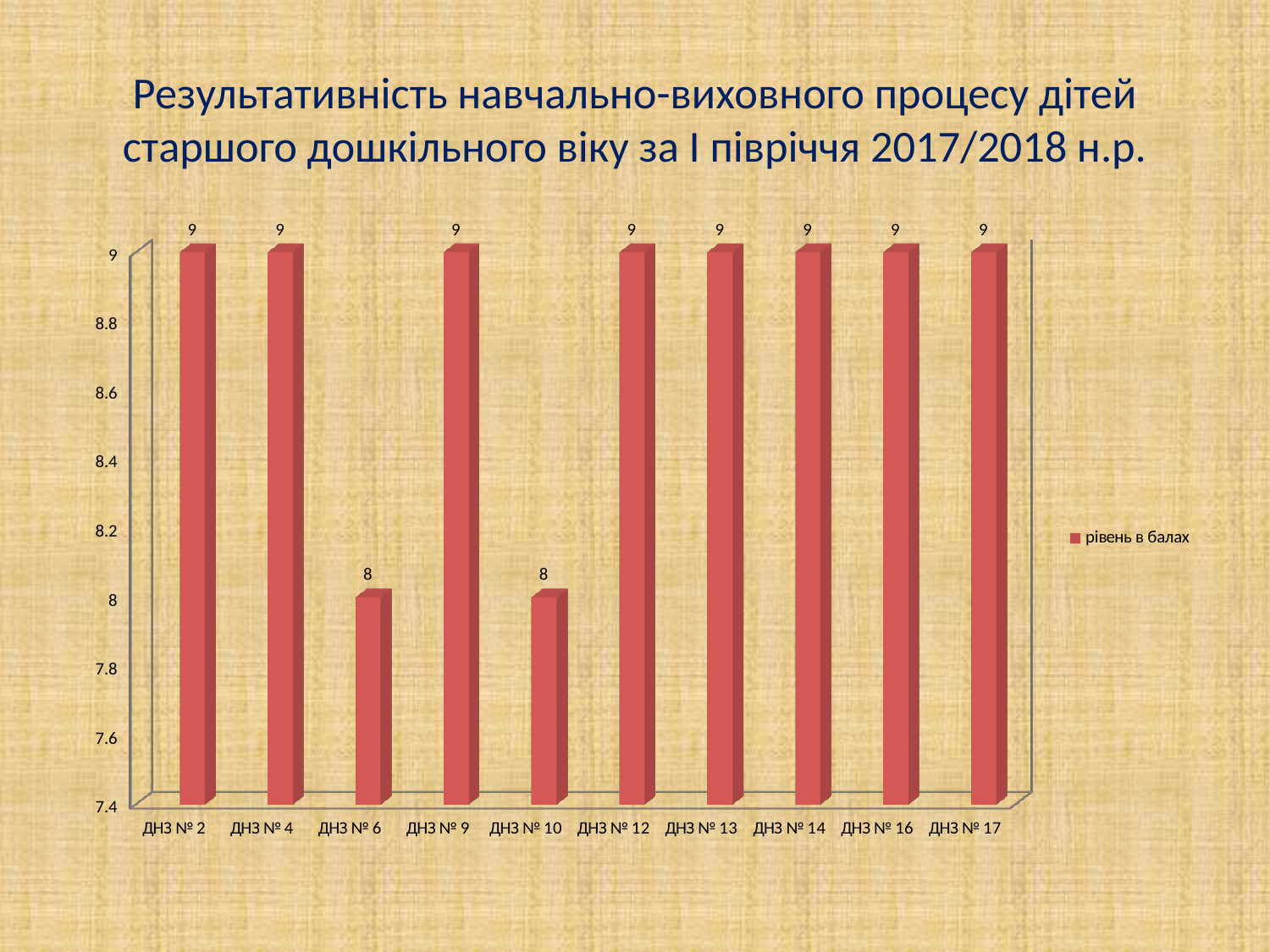
What is the difference between the values for ДНЗ № 9 and ДНЗ № 10? 1 Which is larger, the value for ДНЗ № 4 or the value for ДНЗ № 6? ДНЗ № 4 What is the value for ДНЗ № 12? 9 What is the legend entry for the series? рівень в балах What is the value for ДНЗ № 17? 9 How many categories are shown on the x axis? 10 Which two categories have the lowest value? ДНЗ № 6 and ДНЗ № 10 What kind of chart is shown on the slide? bar chart How many series does the legend list? 1 What is the value for ДНЗ № 6? 8 Is the value for ДНЗ № 6 greater or less than 8.4? less What is the value for ДНЗ № 10? 8